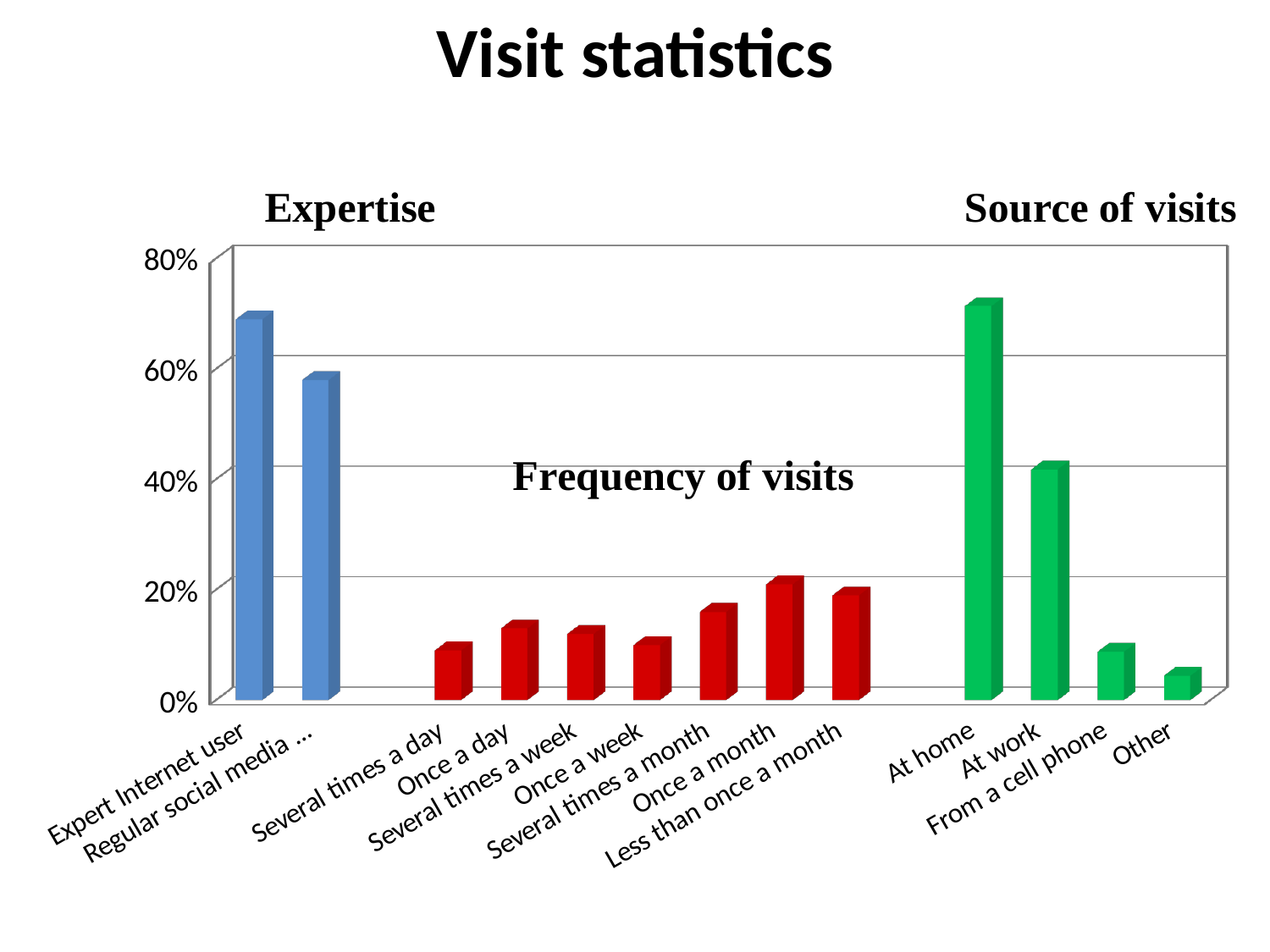
Is the value for Several times a day greater or less than 20%? less Which category in the Source of visits group has the highest value? At home Which is larger, the value for Several times a month or the value for Several times a day? Several times a month What kind of chart is shown on the slide? bar chart How many categories are shown along the x axis? 13 What is the title of the slide's chart? Visit statistics What colour are the bars in the Source of visits group? green Is the value for Other greater or less than 20%? less Which category in the Frequency of visits group has the highest value? Once a month Which category has the lowest value on the chart? Other Which is larger, the value for At home or the value for At work? At home Is the value for Expert Internet user greater or less than 60%? greater